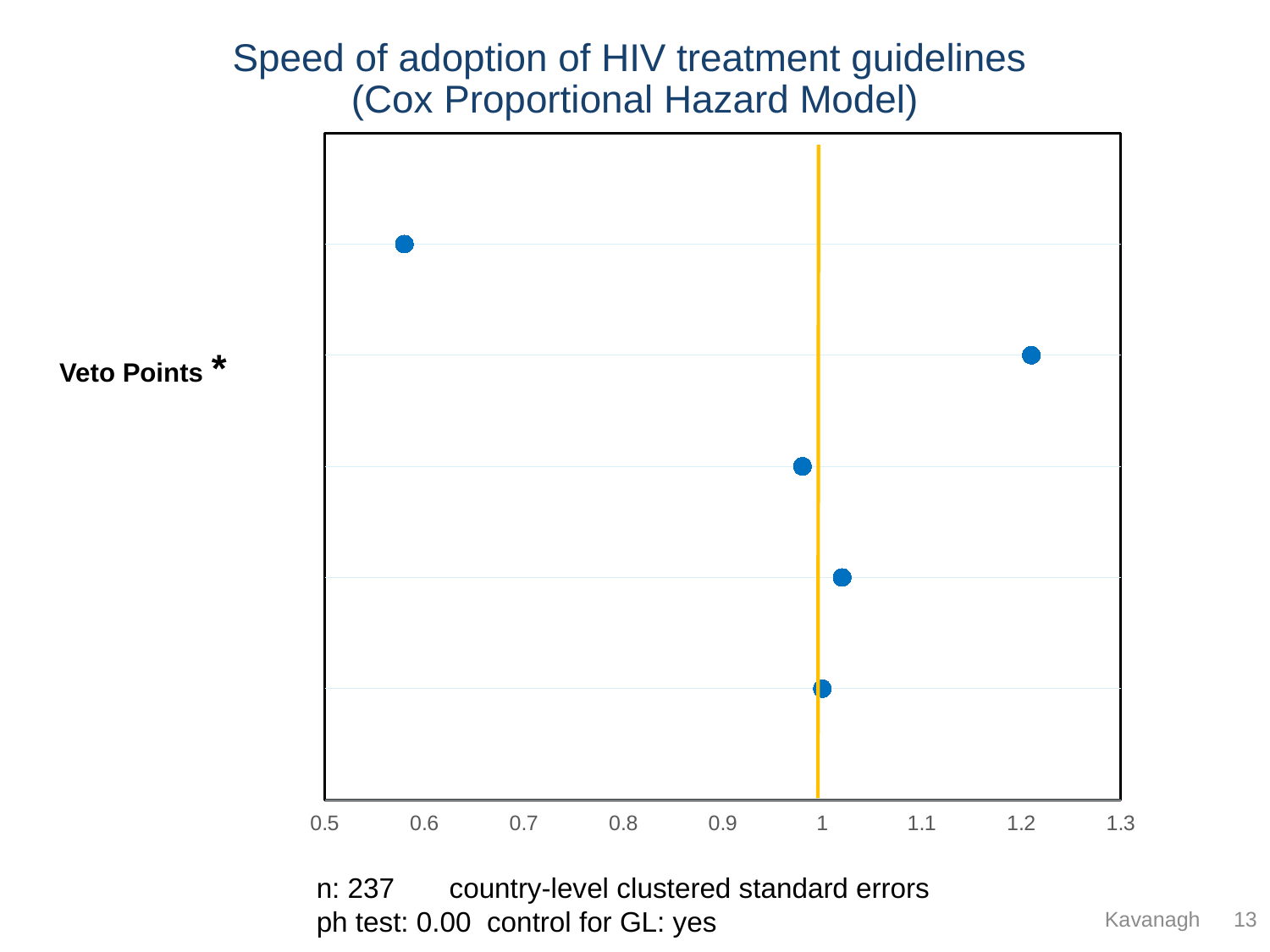
What is the title of the chart? Speed of adoption of HIV treatment guidelines (Cox Proportional Hazard Model) Is the topmost point in the chart greater or less than 0.7? less What is the highest value shown on the x axis? 1.3 What is the lowest value shown on the x axis? 0.5 How many data points are plotted in the chart? 5 What kind of chart is shown on the slide? scatter (dot) plot Is the topmost point in the chart greater or less than 0.5? greater